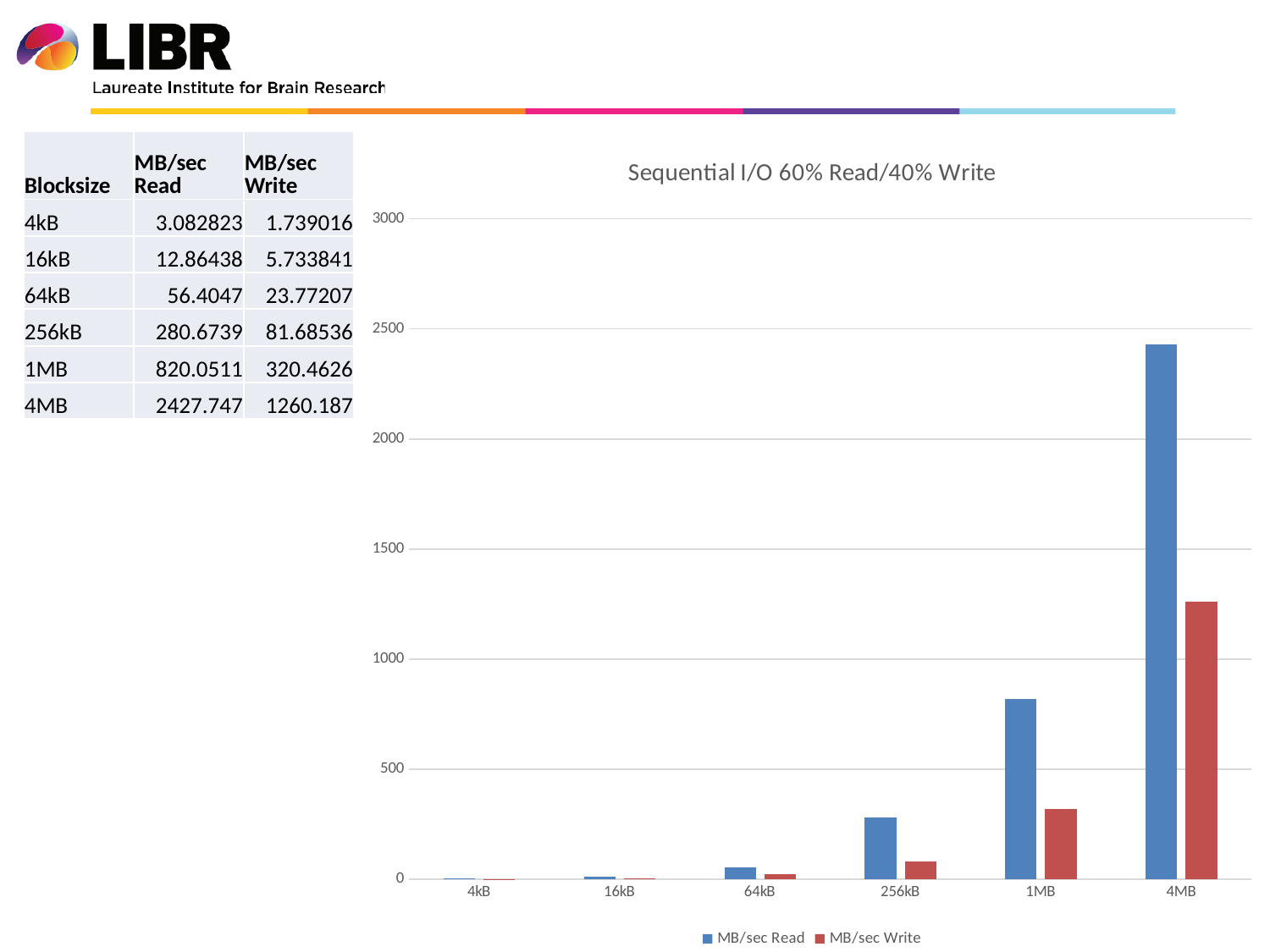
How many blocksize categories are shown on the x axis of the chart? 6 What is the title of the chart? Sequential I/O 60% Read/40% Write What is the MB/sec Read value for the 4MB blocksize? 2427.747 Is the MB/sec Write value for 4MB greater or less than 1000? greater What kind of chart is shown on the slide? bar chart What is the MB/sec Write value for the 1MB blocksize? 320.4626 Do the MB/sec Read values rise or fall as blocksize increases along the x axis? rise Which blocksize has the lowest MB/sec Write value? 4kB Is the MB/sec Read value for 1MB greater or less than 1000? less Which blocksize has the highest MB/sec Read value? 4MB Which is larger for the 256kB blocksize, MB/sec Read or MB/sec Write? MB/sec Read How many series does the chart legend list? 2